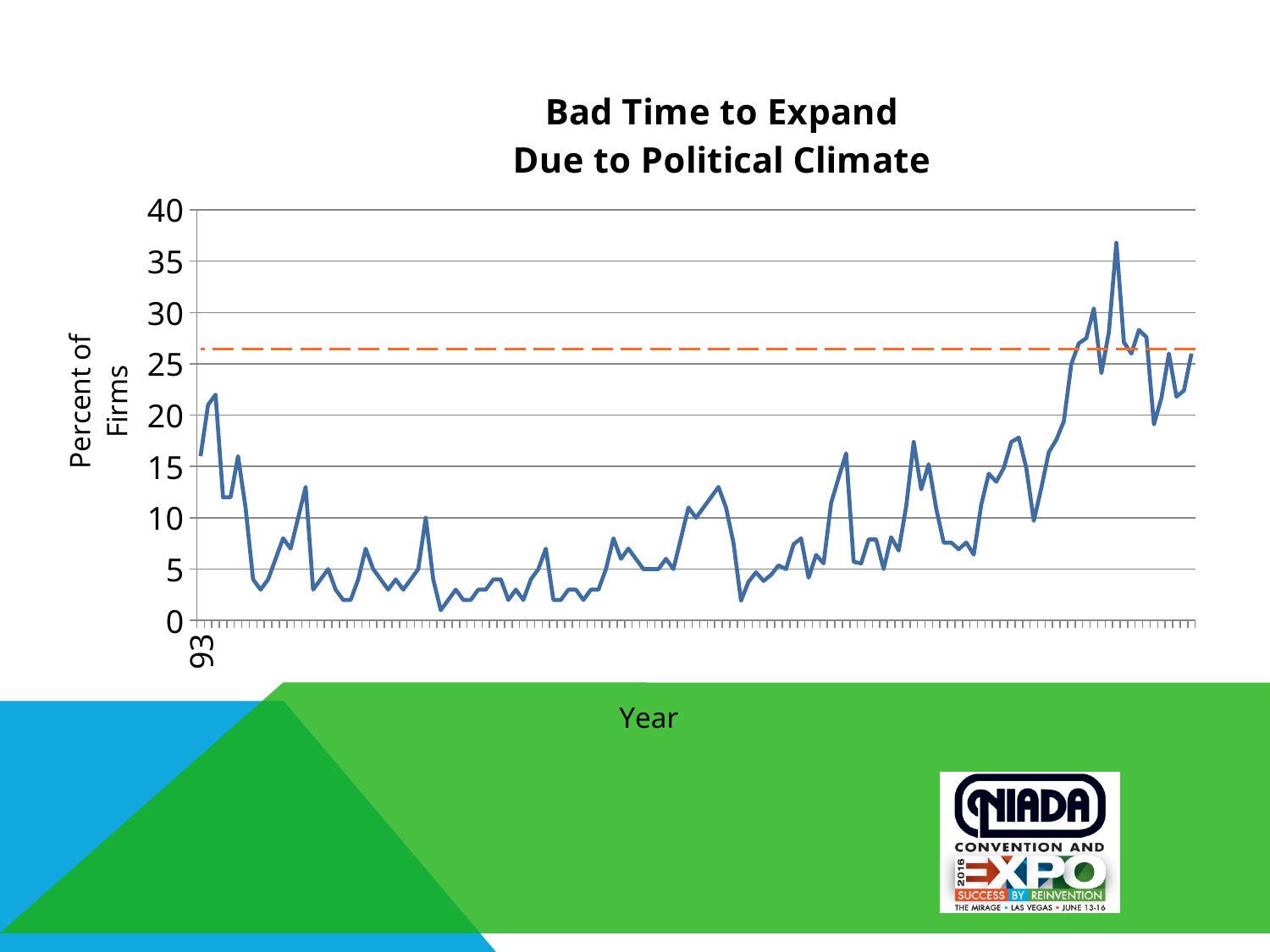
Is the value for 93, the first point on the line, greater or less than 10? greater Is the highest value reached by the solid line greater or less than 35? greater What kind of chart is shown on the slide? Line chart Is the dashed horizontal line above or below the 25 gridline? above Does the solid line end higher or lower than it starts at 93? higher What is the maximum value shown on the vertical axis? 40 What is the title of the chart? Bad Time to Expand Due to Political Climate What is the label of the vertical axis? Percent of Firms